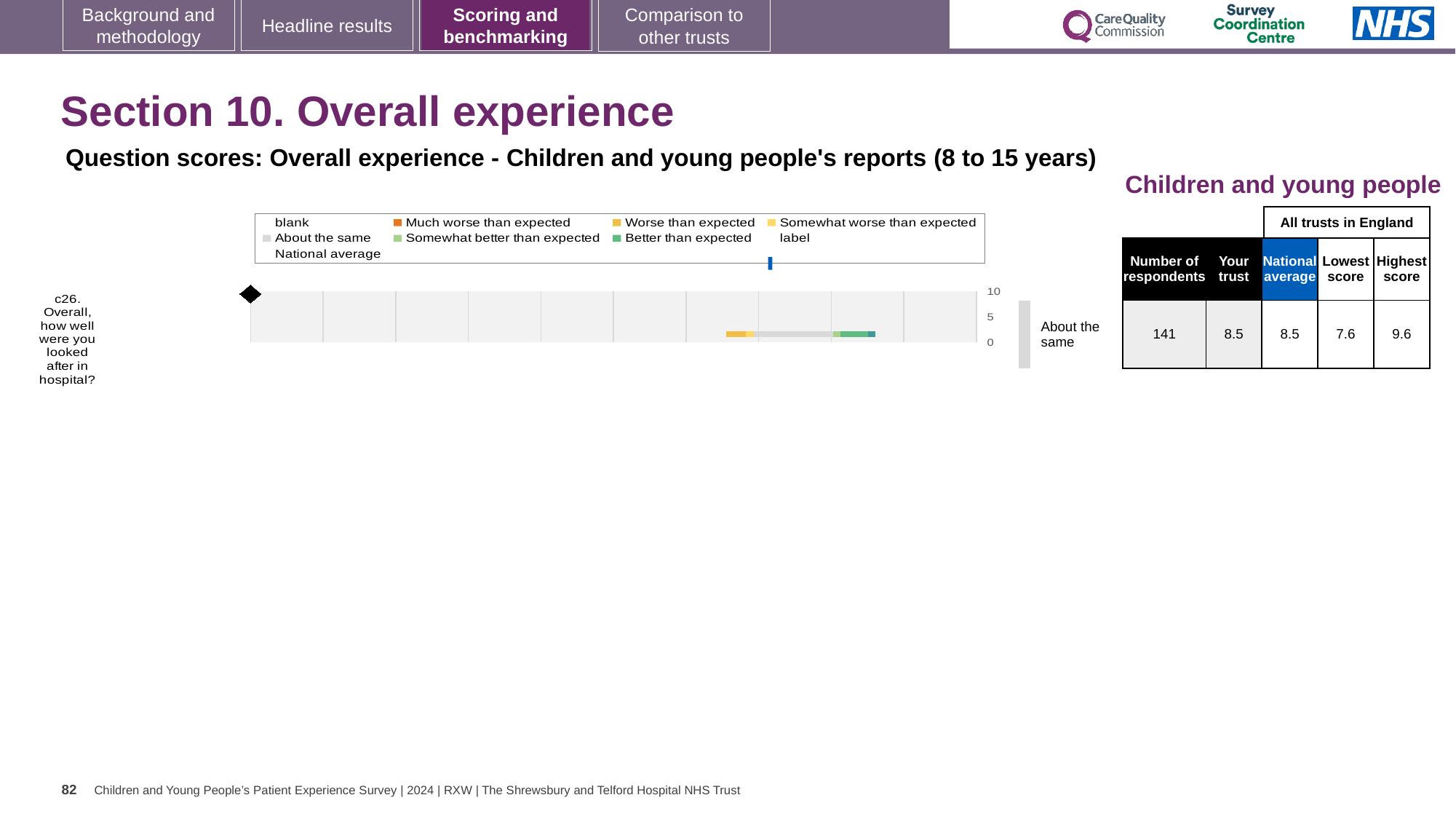
What is the difference between the highest score and the lowest score for question c26? 2.0 In the table, what is the lowest score among all trusts in England for question c26? 7.6 In the table, what is the highest score among all trusts in England for question c26? 9.6 Is the 'Your trust' score for c26 higher than, lower than, or the same as the national average? the same In the table, what is the national average score for question c26? 8.5 What is the label of the question plotted in the chart? c26. Overall, how well were you looked after in hospital? What benchmark category label is shown to the right of the bar for question c26? About the same How many survey questions are plotted in the chart? 1 In the table, what is the number of respondents for question c26? 141 What kind of chart is used to show the question score for c26? bar chart In the table, what is the 'Your trust' score for question c26? 8.5 What is the highest value shown on the chart's vertical axis? 10